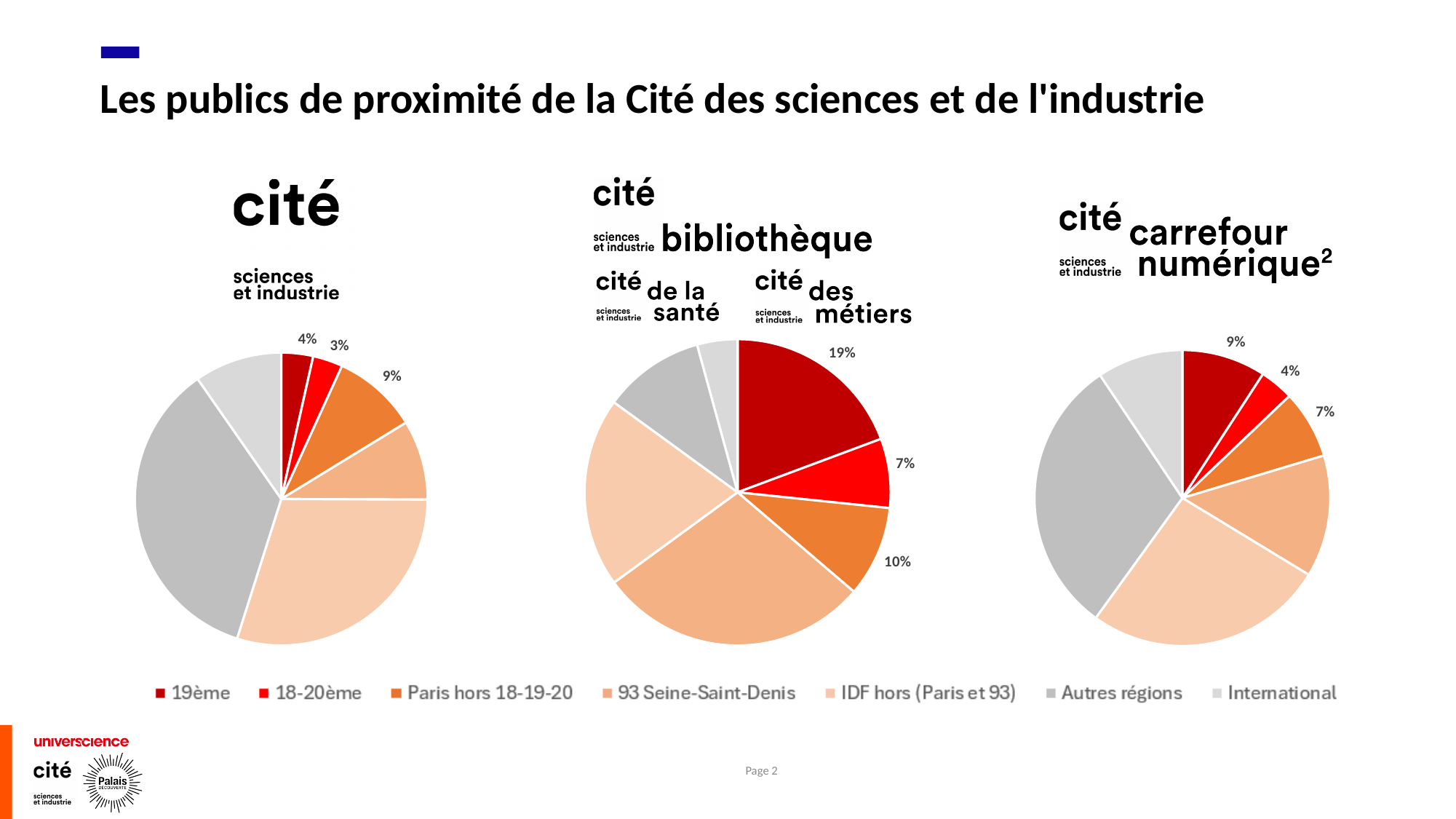
In the right pie chart (carrefour numérique), what share is labelled for the 18-20ème slice? 4% In the middle pie chart (bibliothèque / santé / métiers), what share is labelled for the Paris hors 18-19-20 slice? 10% In the left pie chart (Cité des sciences et de l'industrie), what is the difference in percentage points between the Paris hors 18-19-20 slice and the 18-20ème slice? 6 percentage points Which chart shows the larger share for the 19ème slice, the left chart (Cité des sciences et de l'industrie) or the middle chart (bibliothèque / santé / métiers)? The middle chart (bibliothèque / santé / métiers) In the left pie chart (Cité des sciences et de l'industrie), what share is labelled for the 19ème slice? 4% How many categories does the legend list? 7 In the middle pie chart (bibliothèque / santé / métiers), what share is labelled for the 19ème slice? 19% What kind of charts are shown on the slide? Pie charts In the left pie chart (Cité des sciences et de l'industrie), which category has the largest slice? Autres régions How many pie charts are on the slide? 3 In the right pie chart (carrefour numérique), what share is labelled for the 19ème slice? 9% In the left pie chart (Cité des sciences et de l'industrie), what share is labelled for the Paris hors 18-19-20 slice? 9%